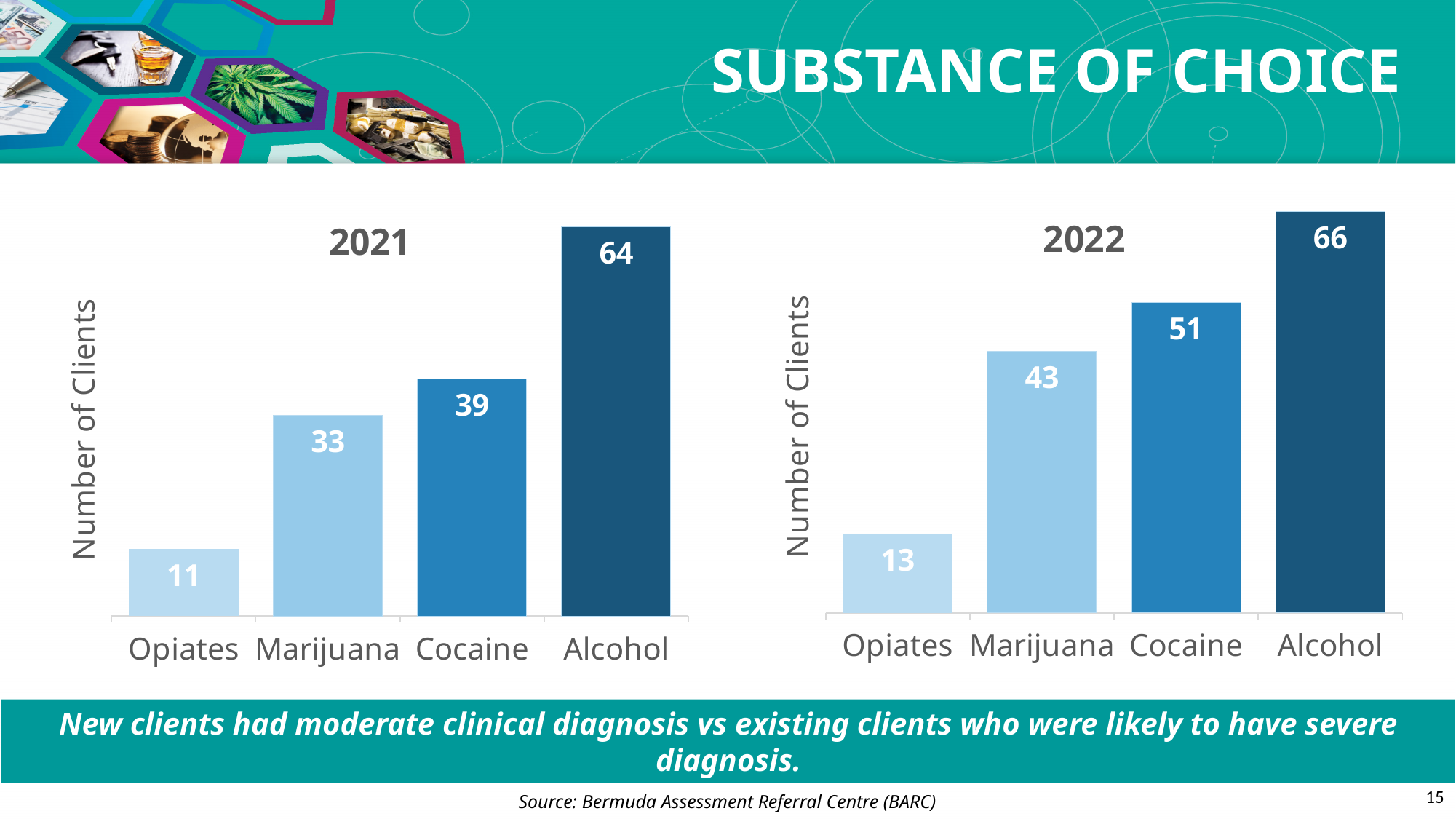
What is the title of the chart on the right side of the slide? 2022 How many substance categories are shown in the 2021 chart? 4 In the 2021 chart, what is the difference in number of clients between Alcohol and Opiates? 53 In the 2022 chart, which substance has the lowest number of clients? Opiates In the 2021 chart, which substance has the highest number of clients? Alcohol In the 2021 chart, do the values rise or fall from Opiates to Alcohol along the x axis? Rise What type of chart is the 2022 chart? Bar chart In the 2021 chart, what is the number of clients for Cocaine? 39 In the 2022 chart, what is the difference in number of clients between Cocaine and Marijuana? 8 In the 2022 chart, which has more clients, Cocaine or Marijuana? Cocaine In the 2022 chart, what is the number of clients for Marijuana? 43 What is the y-axis label on the 2021 chart? Number of Clients